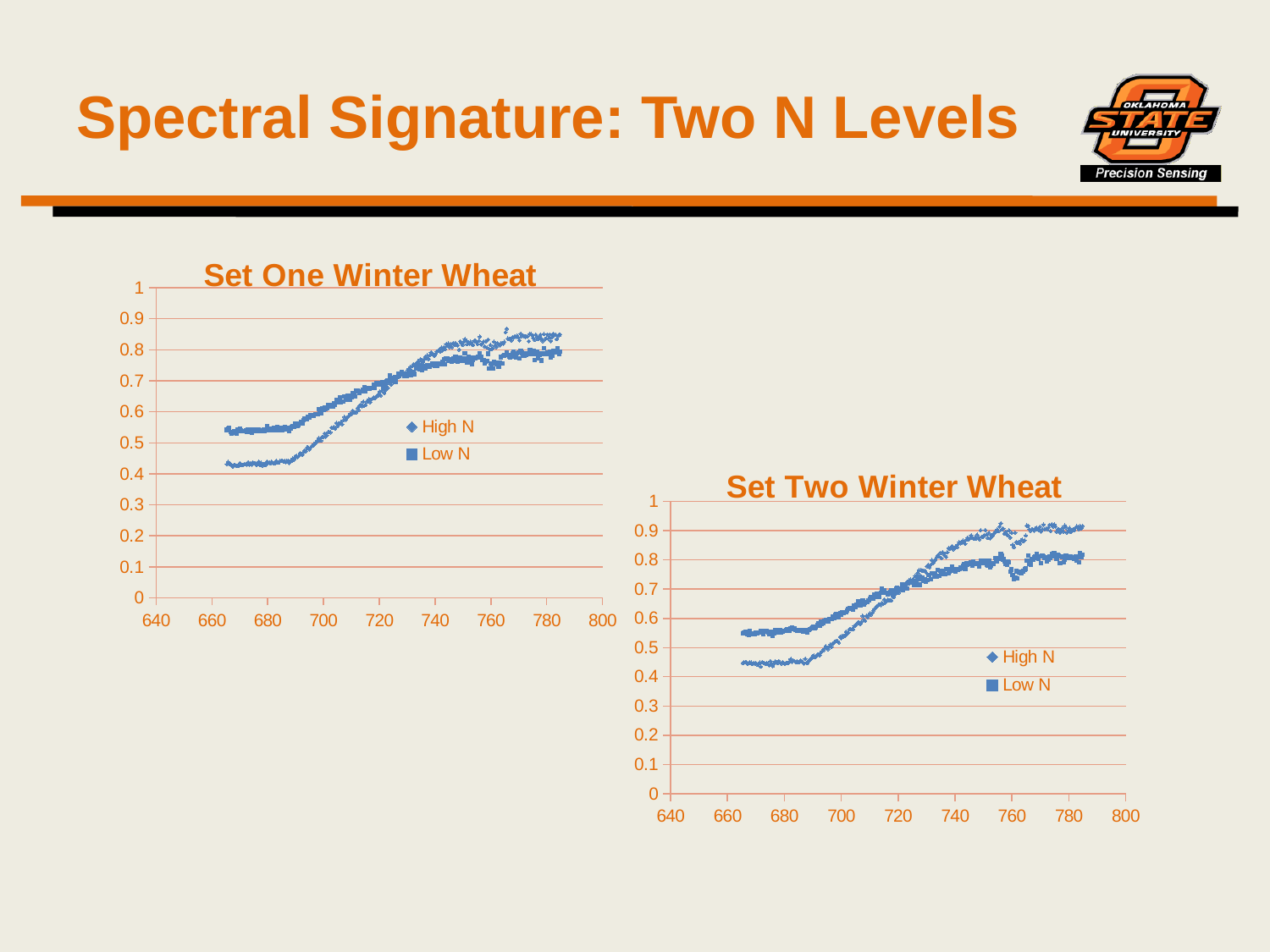
What is the highest value shown on the y axis of the "Set Two Winter Wheat" chart? 1 In the "Set Two Winter Wheat" chart, is the High N value at 780 greater or less than 0.8? greater In the "Set Two Winter Wheat" chart, do the values generally rise or fall as the x axis increases from 660 to 780? rise In the "Set One Winter Wheat" chart, do the values generally rise or fall as the x axis increases from 660 to 780? rise What type of chart is the "Set One Winter Wheat" chart? scatter chart What are the two series named in the legend of the "Set One Winter Wheat" chart? High N and Low N How many charts are shown on the slide? 2 How many series does the legend of the "Set Two Winter Wheat" chart list? 2 In the "Set Two Winter Wheat" chart, which series has the higher value at 780, High N or Low N? High N